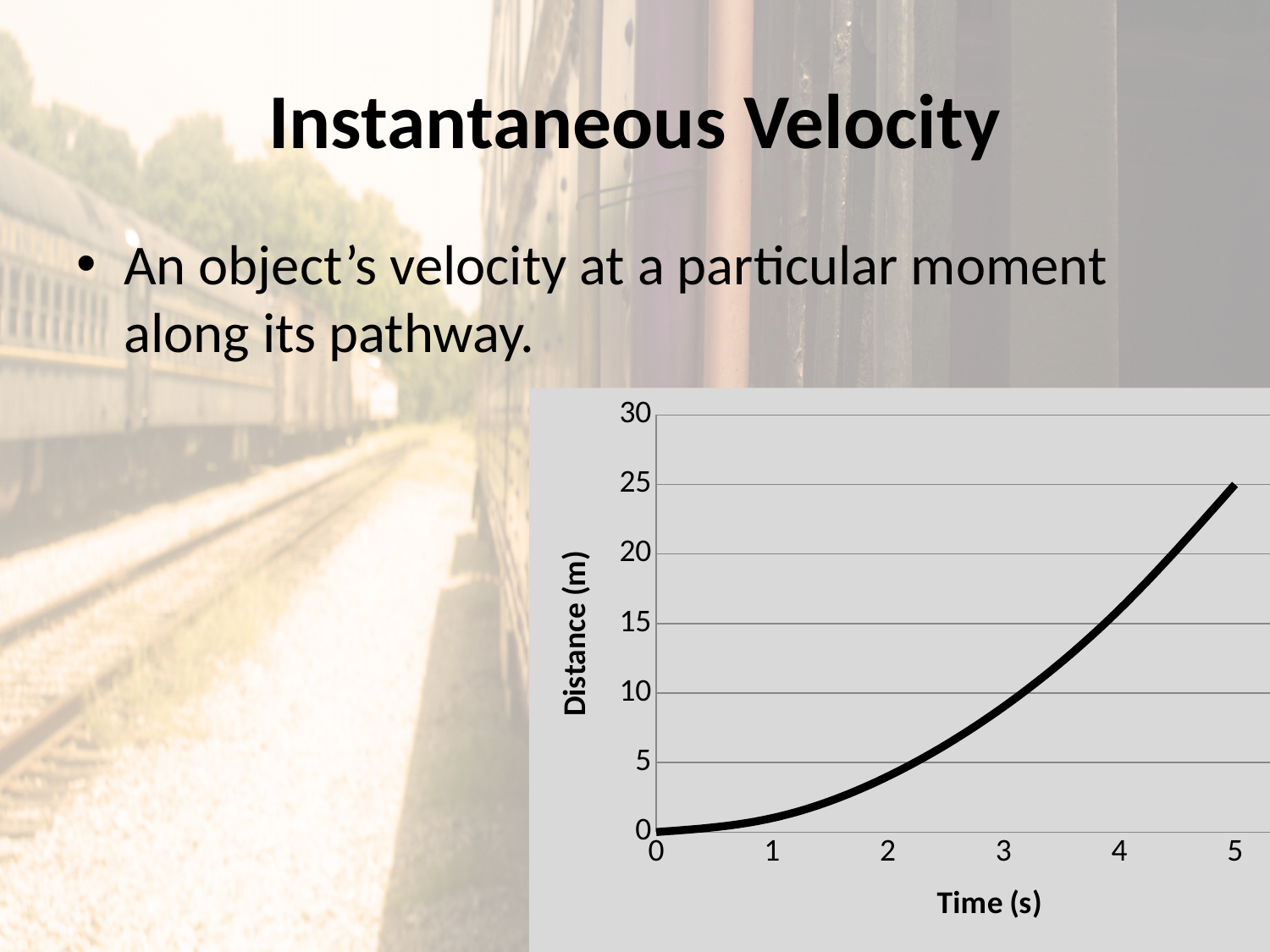
At which time is the distance highest? 5 Is the distance at 1 s greater or less than 5? less What is the distance at a time of 5 s? 25 Is the distance at 4 s greater or less than 20? less What is the label of the vertical axis of the chart? Distance (m) What is the label of the horizontal axis of the chart? Time (s) Which is larger, the distance at 2 s or the distance at 4 s? the distance at 4 s At which time is the distance lowest? 0 What is the distance at a time of 0 s? 0 Does the distance rise or fall as time increases along the x axis? rise What kind of chart is shown on the slide? line chart Is the distance at 3 s greater or less than 5? greater